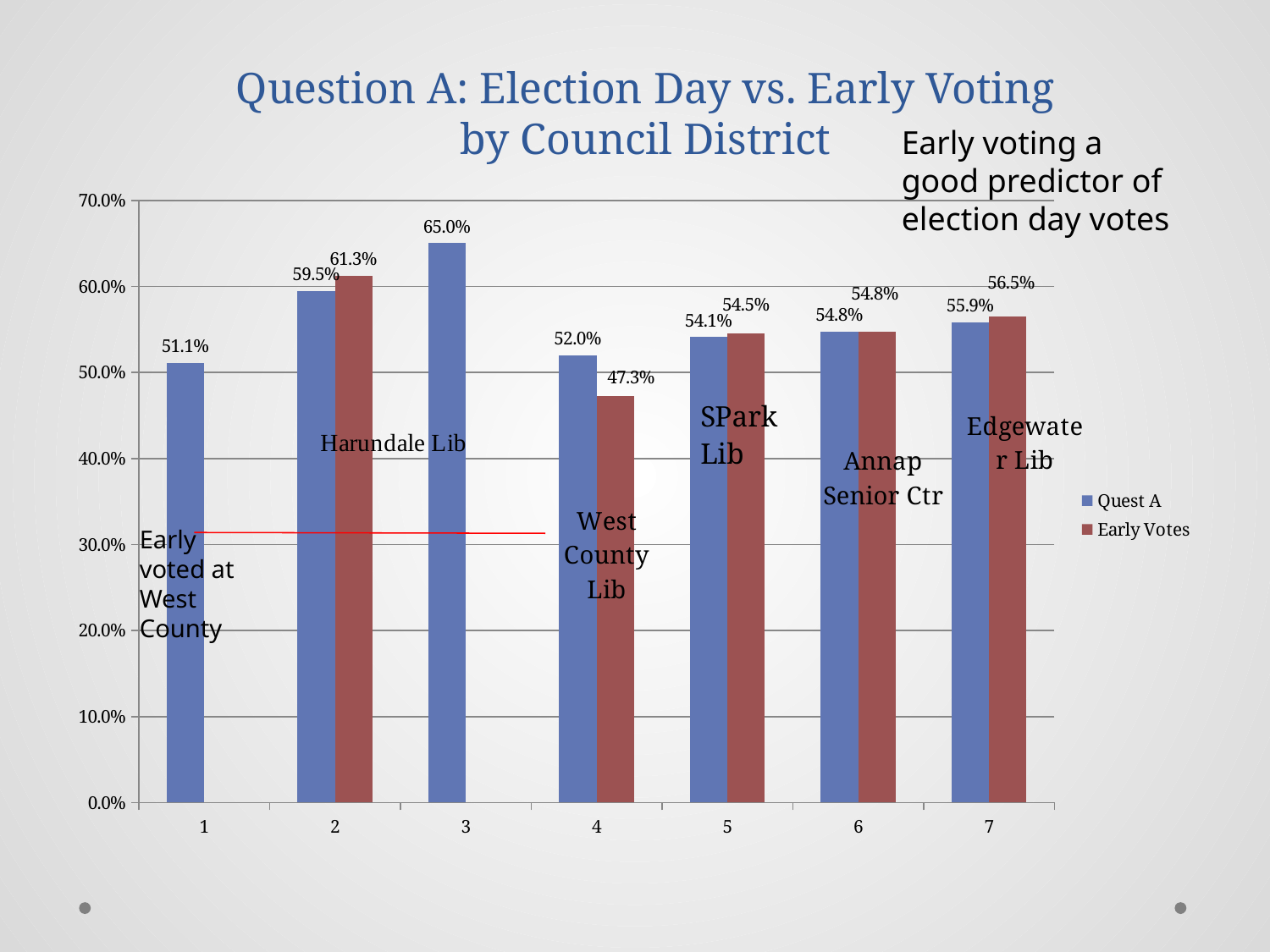
Is the Quest A value for district 3 greater or less than 60.0%? greater Which district has the lowest Early Votes value? 4 How many districts are shown on the x axis? 7 What is the Early Votes value for district 4? 47.3% What is the Quest A value for district 3? 65.0% How many series does the legend list? 2 What is the title of the chart? Question A: Election Day vs. Early Voting by Council District For district 4, which is larger: the Quest A value or the Early Votes value? Quest A What is the difference between the Early Votes and Quest A values for district 2? 1.8% What is the Quest A value for district 1? 51.1% Which district has the highest Quest A value? 3 What kind of chart is shown on the slide? bar chart